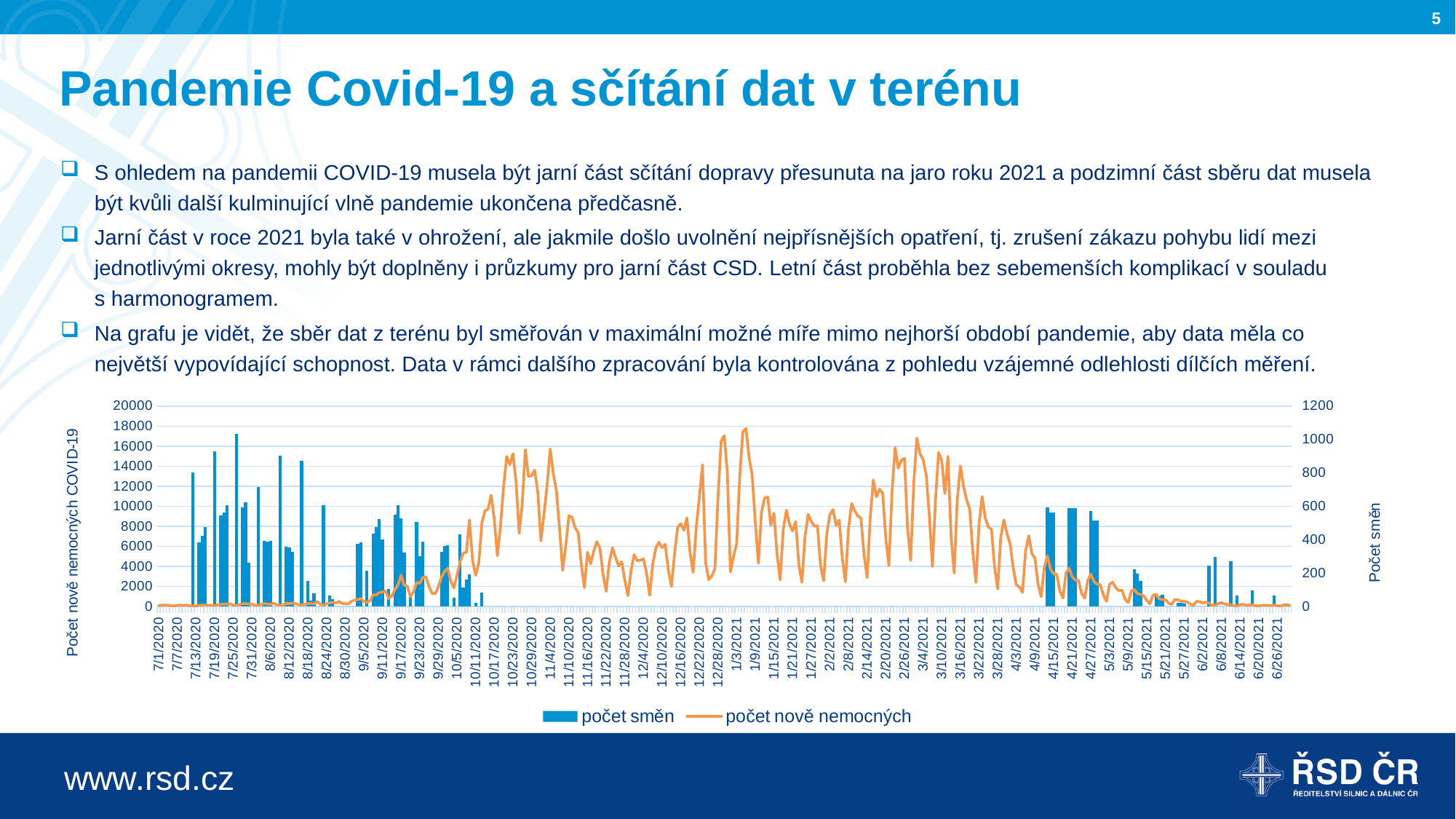
How many series does the chart legend list? 2 Which series is drawn as a line in the chart? počet nově nemocných What is the last date label on the x axis of the chart? 6/26/2021 What is the highest value shown on the left vertical axis of the chart? 20000 Which series is drawn as bars in the chart? počet směn What is the highest value shown on the right vertical axis of the chart? 1200 What is the first date label on the x axis of the chart? 7/1/2020 What kind of chart is shown on the slide? Combined bar and line chart Does the line for počet nově nemocných rise or fall between 3/4/2021 and 6/26/2021? fall Does the line for počet nově nemocných rise or fall between 7/1/2020 and 10/23/2020? rise